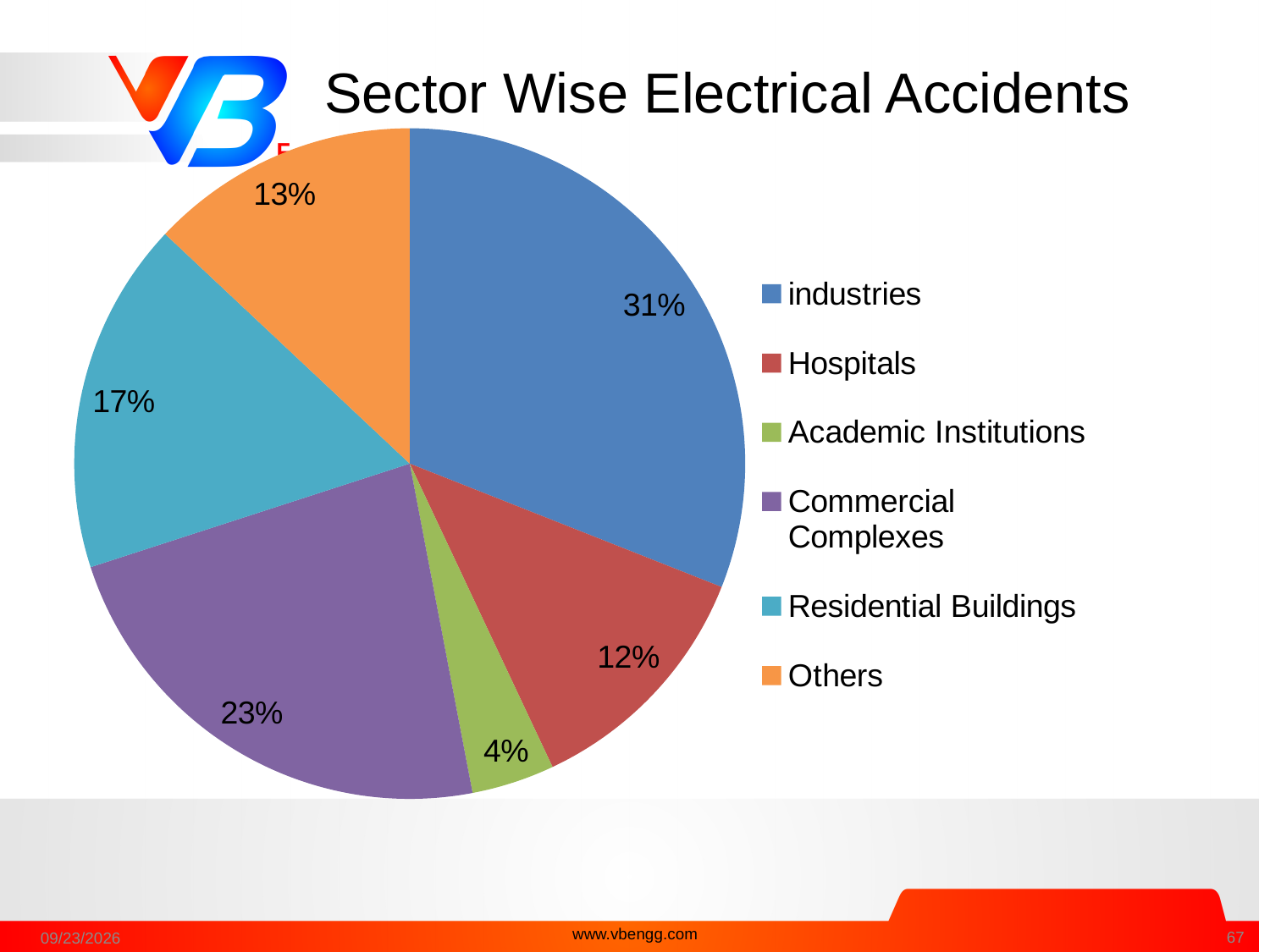
How many sectors are shown in the pie chart? 6 What share of electrical accidents is attributed to industries? 31% What is the difference in percentage points between industries and Commercial Complexes? 8 What is the title of the chart? Sector Wise Electrical Accidents What share of electrical accidents is attributed to Commercial Complexes? 23% Which sector has the largest share of electrical accidents? industries What share of electrical accidents is attributed to Academic Institutions? 4% Which has a larger share, Residential Buildings or Others? Residential Buildings What share of electrical accidents is attributed to Residential Buildings? 17% Which sector has the smallest share of electrical accidents? Academic Institutions What share of electrical accidents is attributed to Hospitals? 12% What type of chart is shown on the slide? pie chart